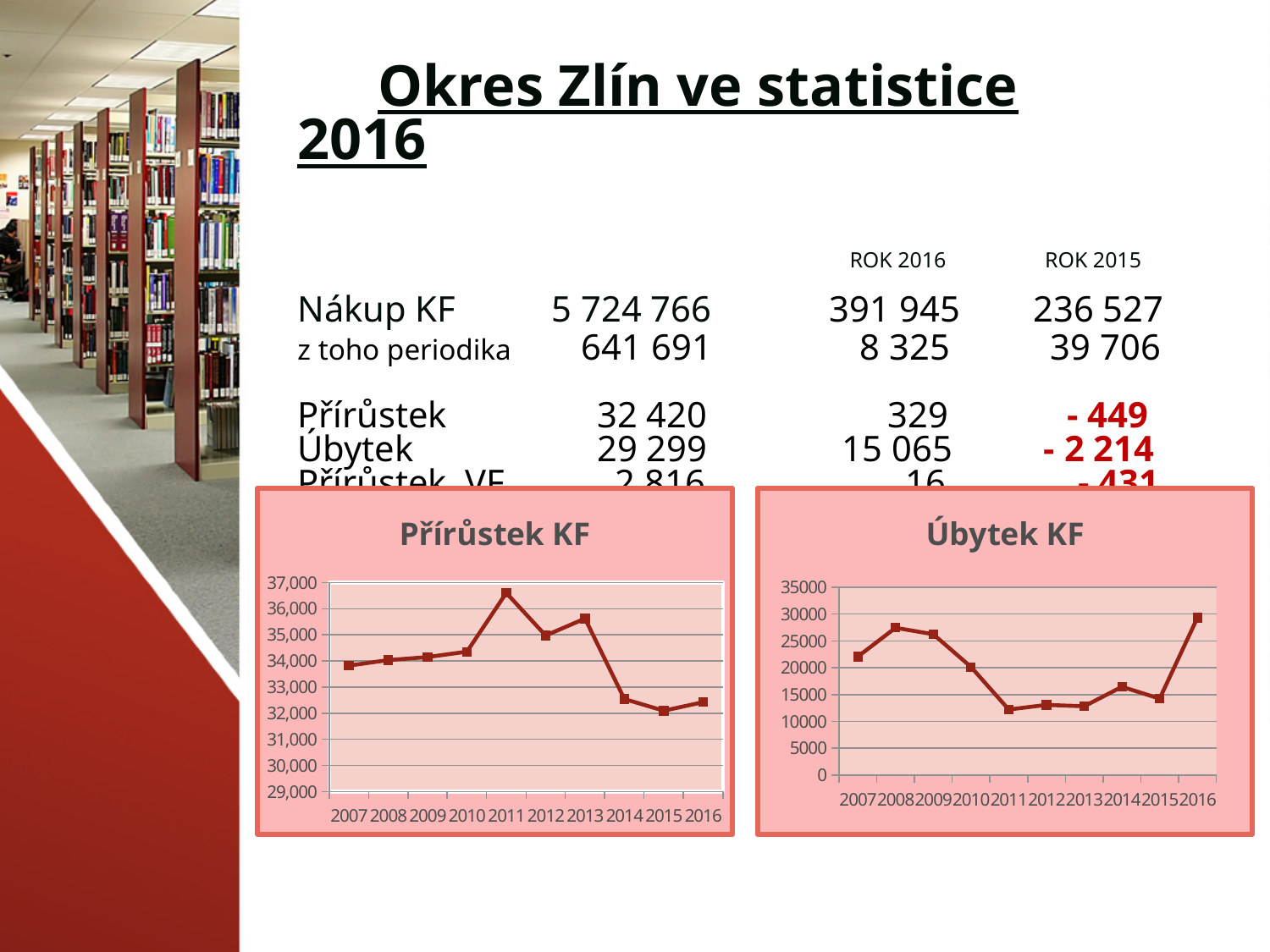
In the "Úbytek KF" chart, is the value for 2011 greater or less than 15000? less In the "Úbytek KF" chart, which year has the larger value, 2008 or 2010? 2008 In the "Přírůstek KF" chart, which year has the lowest value? 2015 In the "Přírůstek KF" chart, is the value for 2015 greater or less than 33,000? less In the "Přírůstek KF" chart, which year has the highest value? 2011 In the "Přírůstek KF" chart, which year has the larger value, 2013 or 2014? 2013 In the "Úbytek KF" chart, which year has the highest value? 2016 In the "Úbytek KF" chart, is the value for 2016 greater or less than 25000? greater What is the title of the chart on the right side of the slide? Úbytek KF What kind of chart is the "Přírůstek KF" chart? line chart How many years are plotted on the x axis of the "Přírůstek KF" chart? 10